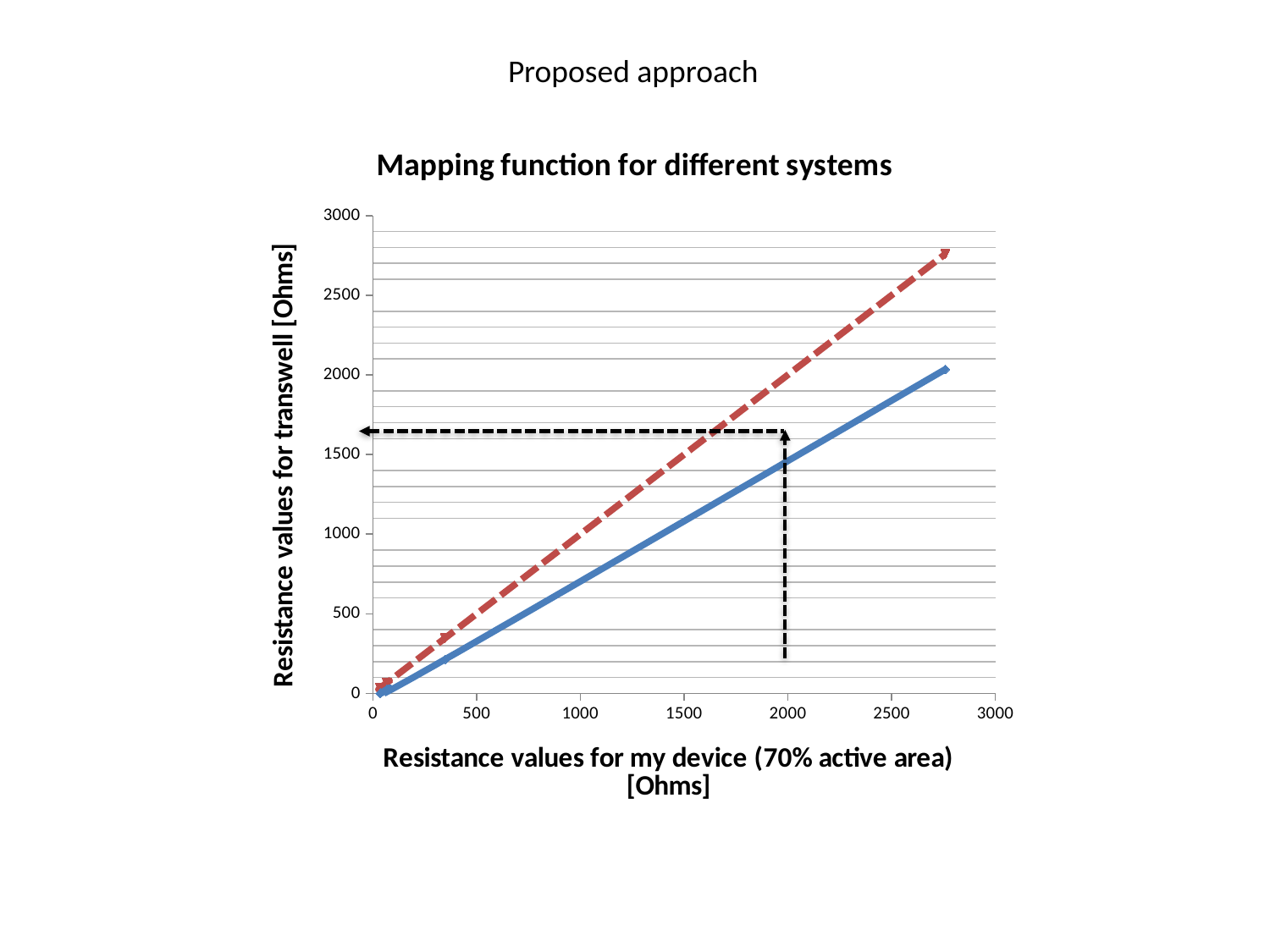
Is the value of the solid blue line at an x-axis value of 1000 greater or less than 1000? less Is the highest value reached by the solid blue line greater or less than 2500? less What is the maximum value shown on the vertical axis? 3000 Is the highest value reached by the dashed red line greater or less than 2500? greater Do the values of the solid blue line rise or fall as the x-axis values increase? Rise What type of chart is shown on the slide? Line chart At an x-axis value of 2000, which line has the higher value: the solid blue line or the dashed red line? The dashed red line How many data series (lines) are plotted on the chart? 2 What is the title of the chart? Mapping function for different systems Do the values of the dashed red line rise or fall as the x-axis values increase? Rise Which line reaches the higher maximum value on the chart: the solid blue line or the dashed red line? The dashed red line What is the label of the vertical axis? Resistance values for transwell [Ohms]